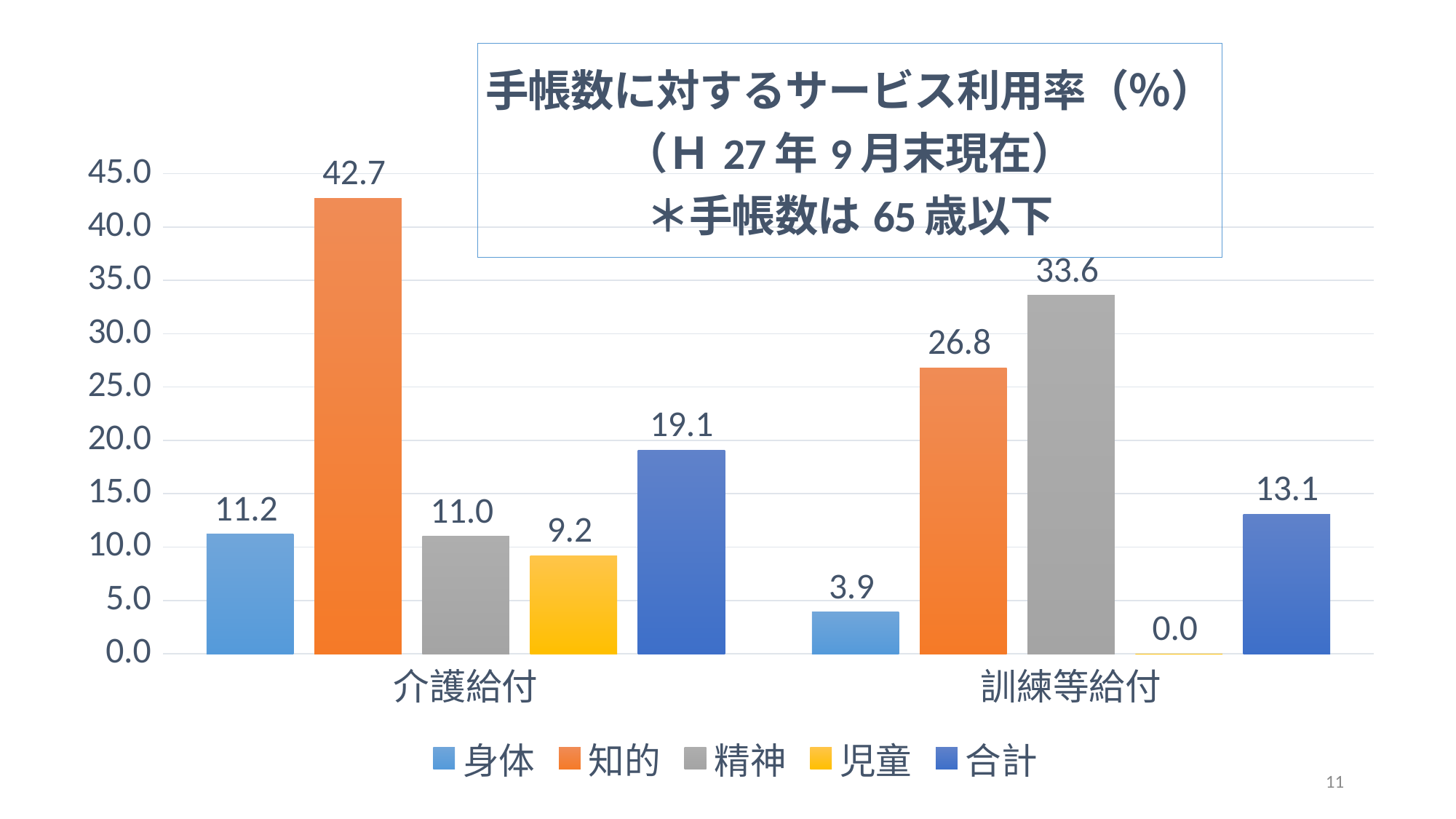
How many series does the legend list? 5 What colour represents the 精神 series? Grey Which series has the highest value in the 介護給付 category? 知的 What is the value for 児童 in the 訓練等給付 category? 0.0 Which is larger: the 身体 value for 介護給付 or for 訓練等給付? 介護給付 What is the value for 知的 in the 介護給付 category? 42.7 What is the value for 精神 in the 訓練等給付 category? 33.6 Which series has the lowest value in the 訓練等給付 category? 児童 What is the difference between the 知的 values for 介護給付 and 訓練等給付? 15.9 What is the value for 合計 in the 介護給付 category? 19.1 How many categories are shown on the x axis? 2 What kind of chart is shown on the slide? Bar chart